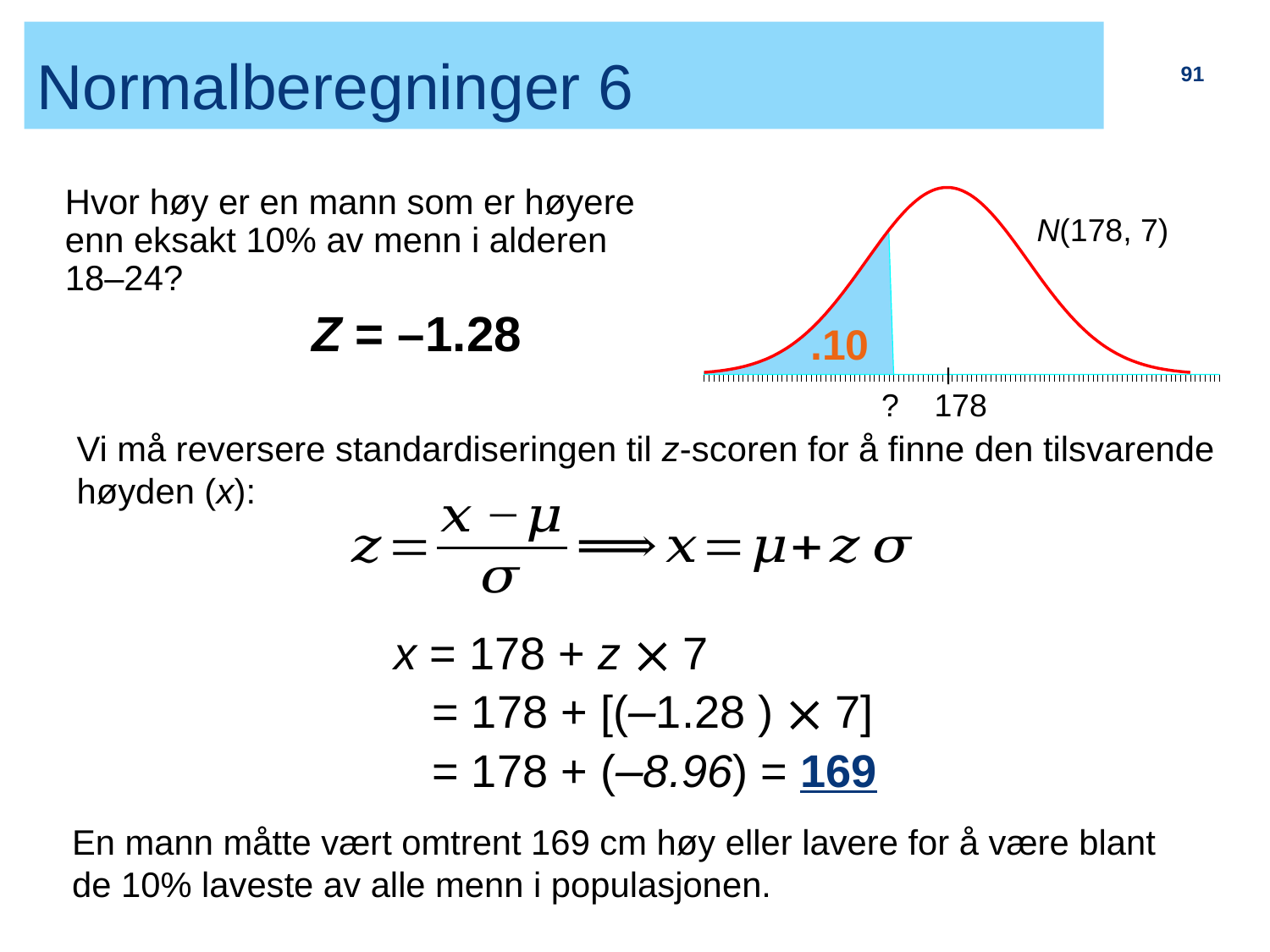
Is the shaded region to the left or to the right of 178 on the axis? left What value is printed inside the shaded region under the curve? .10 What distribution label is printed next to the curve? N(178, 7) What colour is the curve drawn in? red What kind of chart is shown on the slide? a normal distribution curve What value is marked on the horizontal axis at the centre of the curve? 178 What symbol is printed on the horizontal axis at the right edge of the shaded region? ?